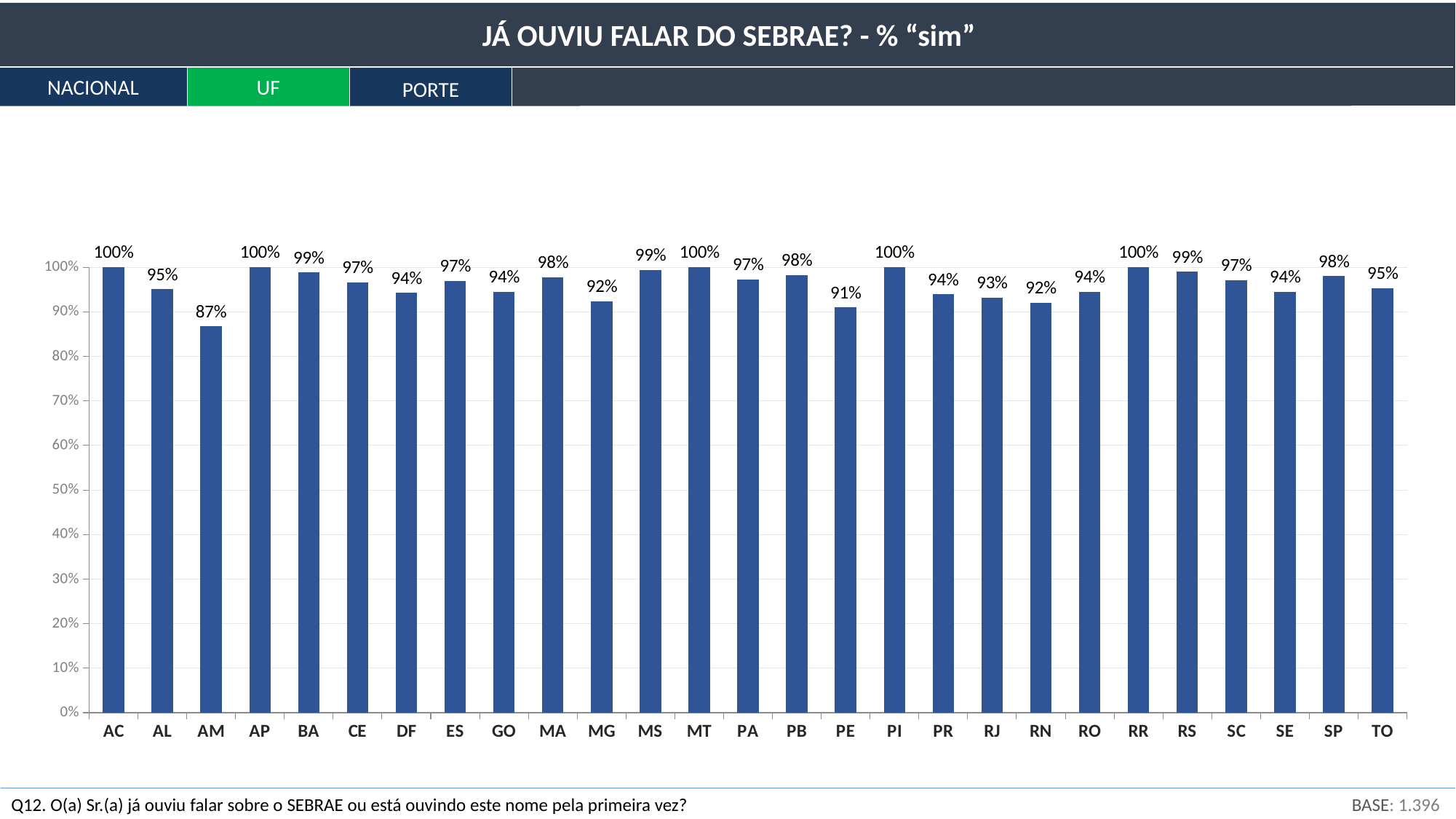
What kind of chart is shown on the slide? bar chart What is the value for PE? 91% Which state has the lowest value? AM What is the difference between the values for AC and AM? 13% What is the title of the chart? JÁ OUVIU FALAR DO SEBRAE? - % "sim" How many states are shown on the x axis? 27 What is the value for AM? 87% Is the value for AM greater or less than 90%? less What is the value for SP? 98% What is the value for RJ? 93% What is the difference between the values for BA and PE? 8% Which is larger, the value for MG or the value for MA? MA